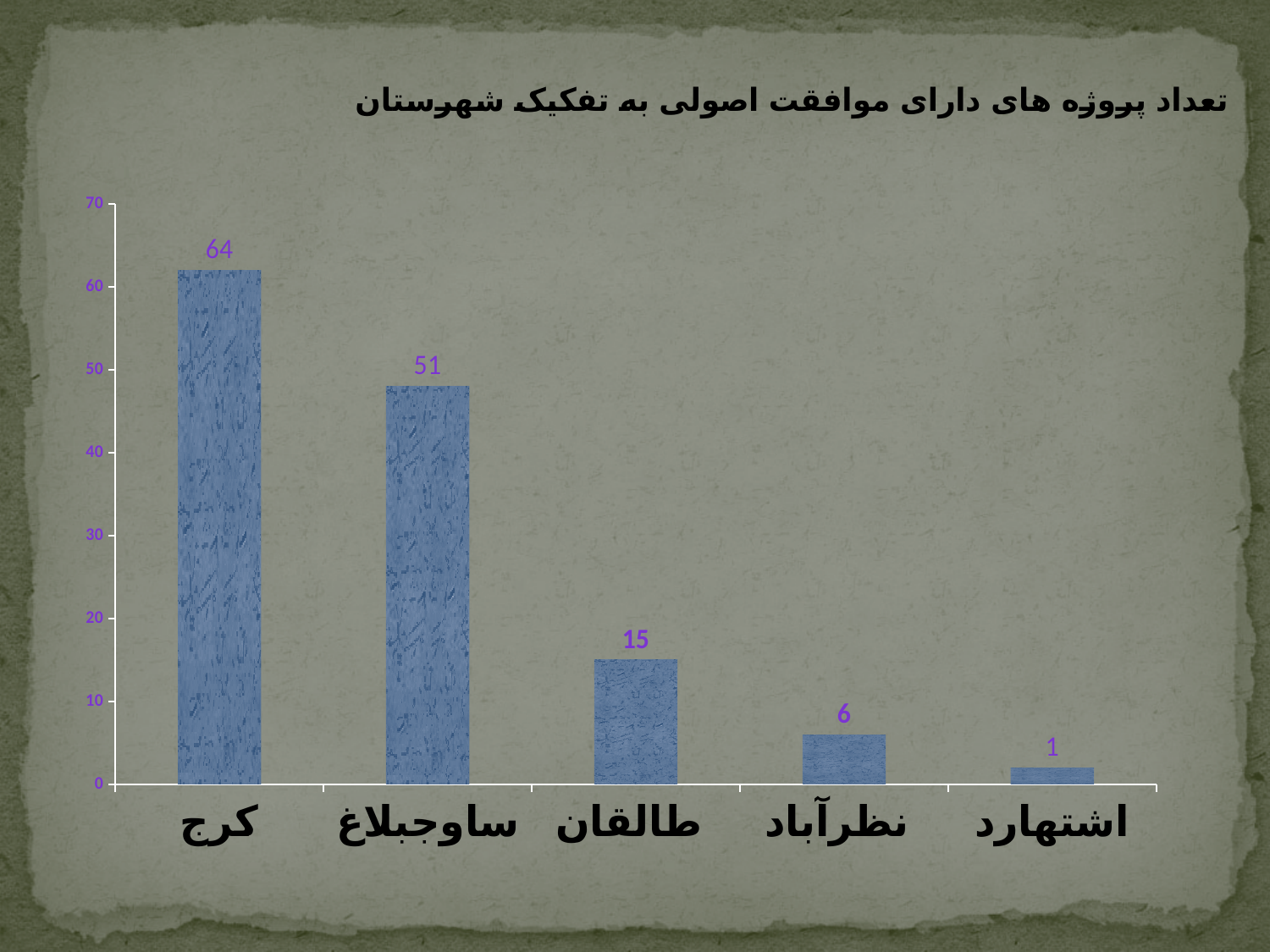
Which category has the highest value? کرج What is the difference between the values for کرج and ساوجبلاغ? 13 What is the value shown for ساوجبلاغ? 51 What is the value shown for کرج? 64 What kind of chart is shown on the slide? bar chart What is the title of the chart? تعداد پروژه های دارای موافقت اصولی به تفکیک شهرستان How many categories are shown on the x axis? 5 What is the value shown for طالقان? 15 Which is larger, the value for طالقان or the value for نظرآباد? طالقان Which category has the lowest value? اشتهارد What is the value shown for نظرآباد? 6 What is the value shown for اشتهارد? 1